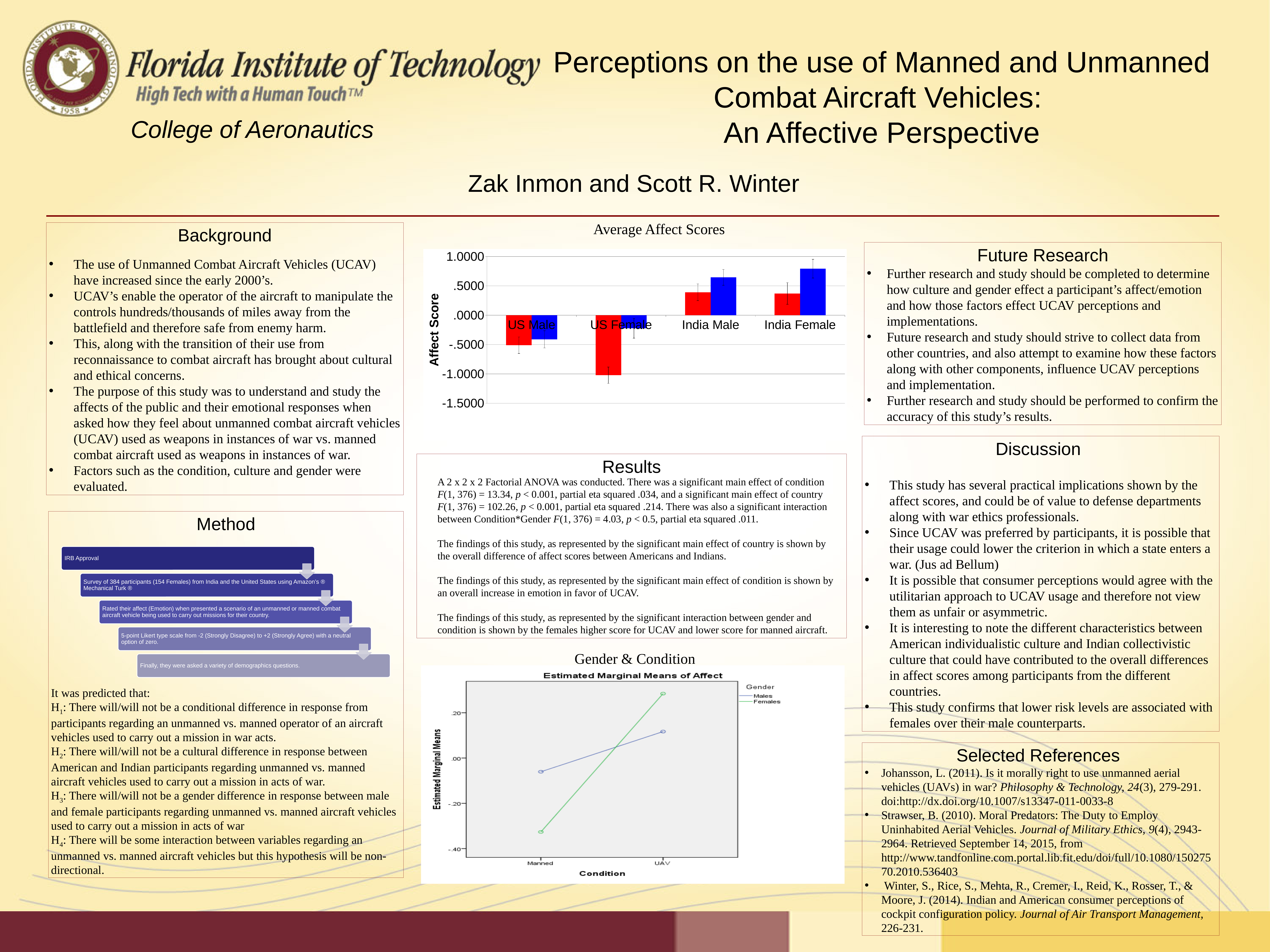
How many categories are shown on the x axis of the 'Average Affect Scores' chart? 4 In the 'Average Affect Scores' chart, is the red bar for US Female greater or less than -.5000? less What is the y-axis label of the 'Average Affect Scores' chart? Affect Score In the 'Average Affect Scores' chart, which category has the lowest red bar? US Female In the 'Gender & Condition' chart, does the Females line rise or fall from Manned to UAV? rise In the 'Average Affect Scores' chart, is the blue bar for India Female greater or less than .5000? greater In the 'Gender & Condition' chart, is the Females value at Manned greater or less than -.20? less How many series does the legend of the 'Gender & Condition' chart list? 2 In the 'Gender & Condition' chart, which series has the higher value at UAV, Males or Females? Females In the 'Average Affect Scores' chart, which has the larger blue bar, US Male or India Male? India Male What kind of chart is the 'Average Affect Scores' chart? bar chart What kind of chart is the 'Gender & Condition' chart? line chart